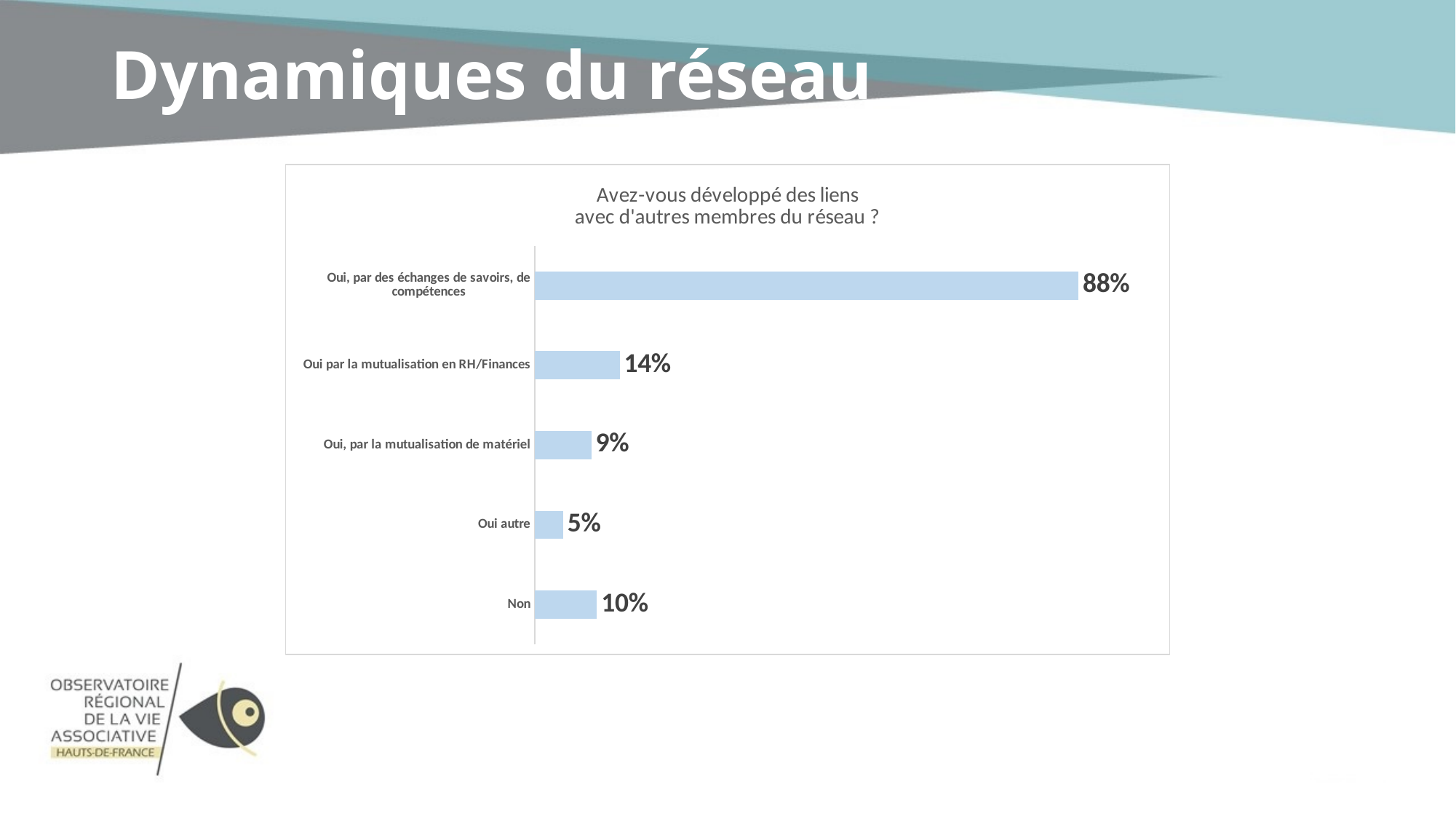
Which is larger, the value for "Non" or the value for "Oui, par la mutualisation de matériel"? Non Which category has the highest value? Oui, par des échanges de savoirs, de compétences How many categories are shown in the chart? 5 What is the value for "Oui autre"? 5% What is the value for "Oui, par des échanges de savoirs, de compétences"? 88% What is the value for "Oui, par la mutualisation de matériel"? 9% What is the difference between the values for "Oui, par des échanges de savoirs, de compétences" and "Oui par la mutualisation en RH/Finances"? 74% What is the title of the chart? Avez-vous développé des liens avec d'autres membres du réseau ? What is the value for "Non"? 10% What is the value for "Oui par la mutualisation en RH/Finances"? 14% Which category has the lowest value? Oui autre What kind of chart is shown on the slide? Bar chart